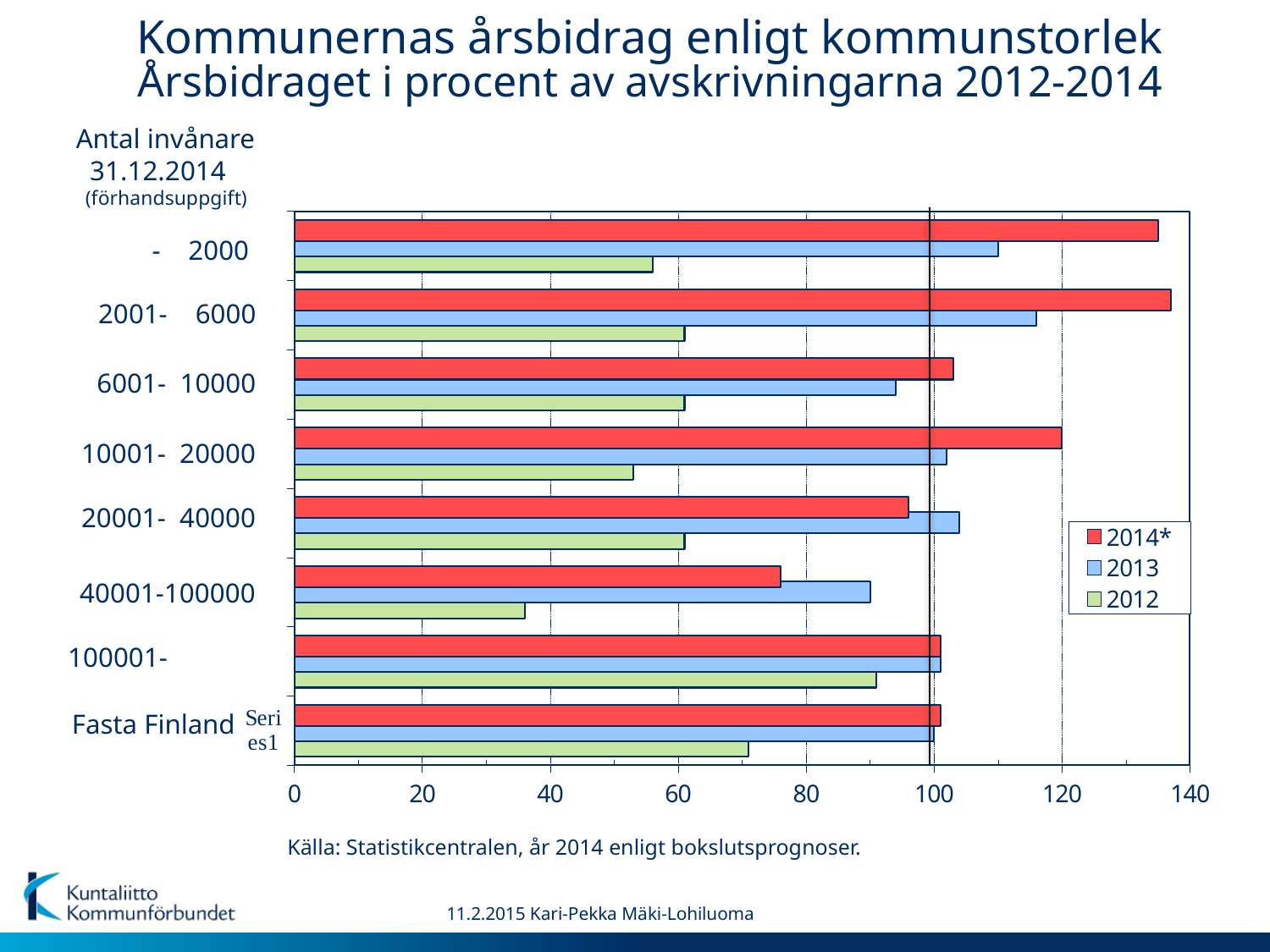
How many series does the legend list? 3 Is the 2014* value for the '- 2000' category greater or less than 120? greater How many categories (municipality size groups, including Fasta Finland) are plotted on the chart? 8 Which category has the lowest value for the 2014* series? 40001-100000 Which category has the lowest value for the 2012 series? 40001-100000 Which category has the highest value for the 2012 series? 100001- Is the 2012 value for the '40001-100000' category greater or less than 40? less Which category has the highest value for the 2013 series? 2001- 6000 What kind of chart is shown on the slide? bar chart Is the 2014* value for the '10001- 20000' category greater or less than 100? greater Which series are listed in the legend? 2014*, 2013, 2012 For the '40001-100000' category, which is larger: the 2014* value or the 2013 value? 2013